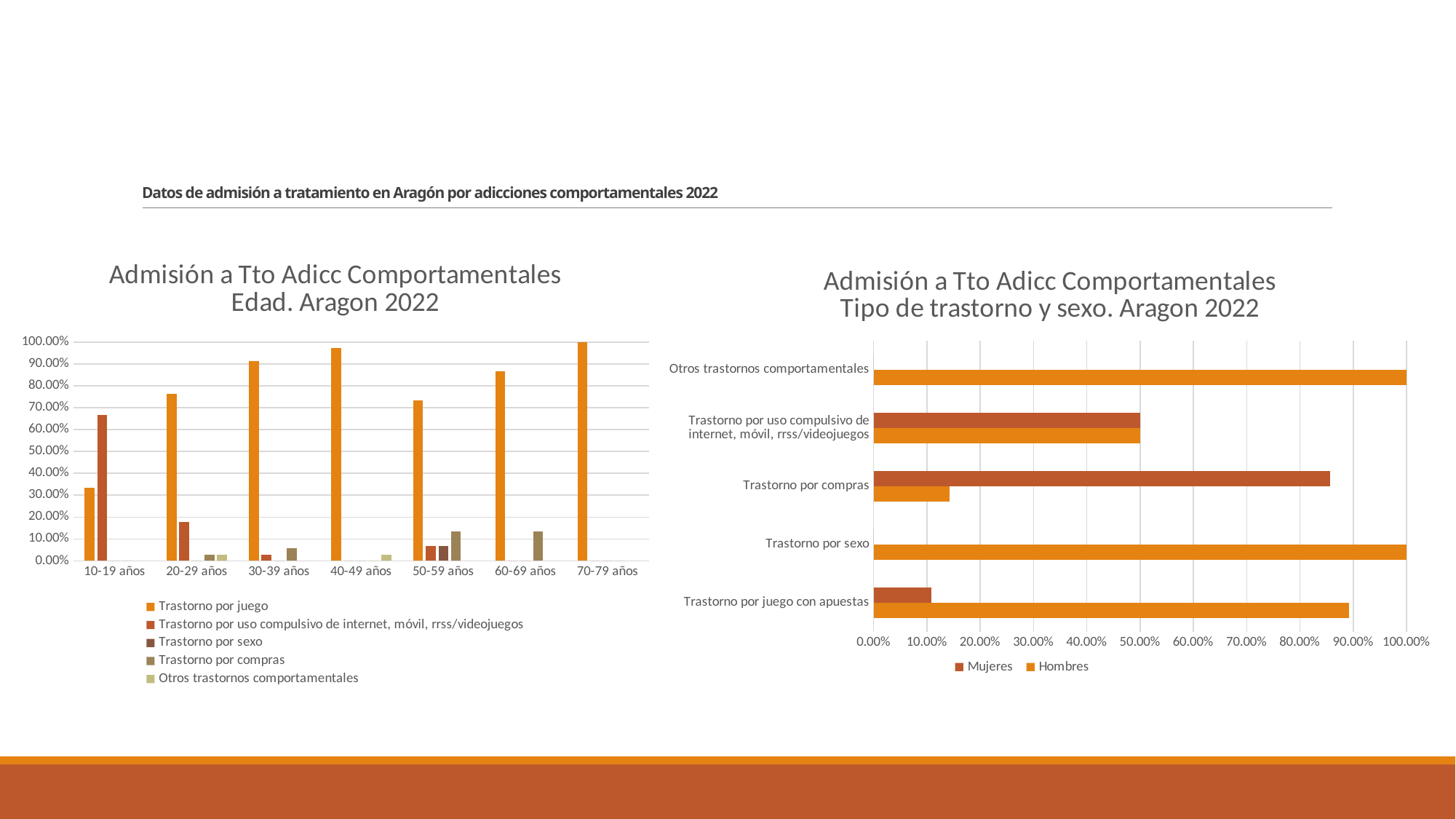
In the left-hand chart (Edad. Aragon 2022), is the value for Trastorno por juego in the 10-19 años group greater or less than 40.00%? less How many disorder categories are shown on the right-hand chart (Tipo de trastorno y sexo)? 5 In the right-hand chart (Tipo de trastorno y sexo), what is the Hombres value for Otros trastornos comportamentales? 100.00% In the left-hand chart (Edad. Aragon 2022), which age group has the lowest value for Trastorno por juego? 10-19 años How many series does the legend of the right-hand chart (Tipo de trastorno y sexo) list? 2 In the left-hand chart (Edad. Aragon 2022), is the value for Trastorno por juego in the 30-39 años group greater or less than 80.00%? greater What kind of chart is the chart titled 'Admisión a Tto Adicc Comportamentales Tipo de trastorno y sexo. Aragon 2022'? bar chart In the right-hand chart (Tipo de trastorno y sexo), is the Mujeres value for Trastorno por juego con apuestas greater or less than 20.00%? less How many age groups are shown on the x axis of the left-hand chart (Edad. Aragon 2022)? 7 What are the two legend entries of the right-hand chart (Tipo de trastorno y sexo)? Mujeres and Hombres How many series does the legend of the chart titled 'Admisión a Tto Adicc Comportamentales Edad. Aragon 2022' list? 5 In the right-hand chart (Tipo de trastorno y sexo), which is larger for Trastorno por compras, Mujeres or Hombres? Mujeres